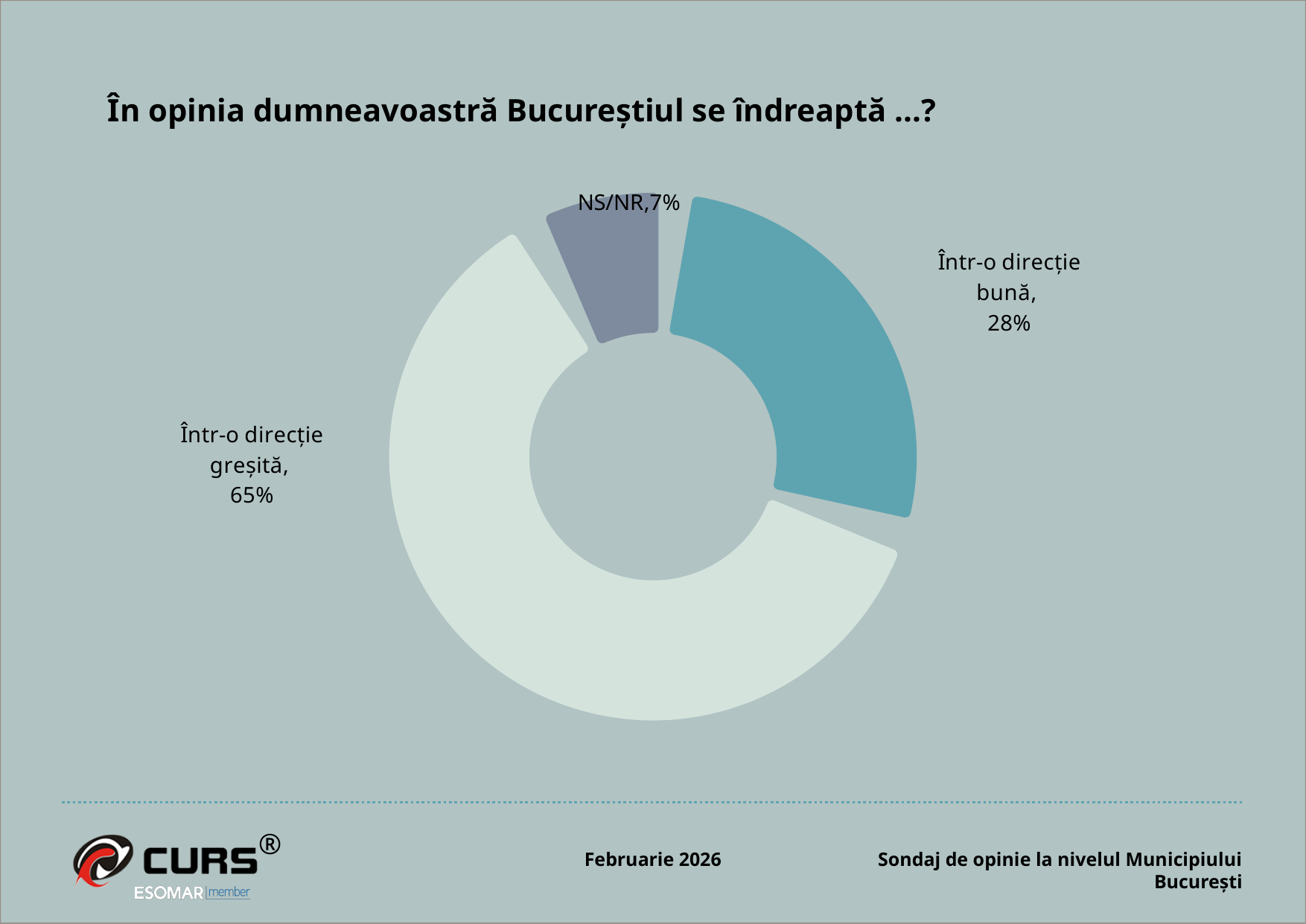
How many categories are shown in the chart? 3 What kind of chart is shown on the slide? Doughnut (pie) chart What percentage of respondents answered "Într-o direcție bună"? 28% Which is larger, the share for "Într-o direcție bună" or the share for NS/NR? Într-o direcție bună What percentage of respondents answered "Într-o direcție greșită"? 65% Which category has the smallest share of the chart? NS/NR What is the difference in percentage points between "Într-o direcție greșită" and "Într-o direcție bună"? 37 What month and year is shown at the bottom of the slide? Februarie 2026 Which category has the largest share of the chart? Într-o direcție greșită What is the value shown for NS/NR? 7% What is the combined share of "Într-o direcție bună" and NS/NR? 35% What is the title of the chart on the slide? În opinia dumneavoastră Bucureștiul se îndreaptă ...?